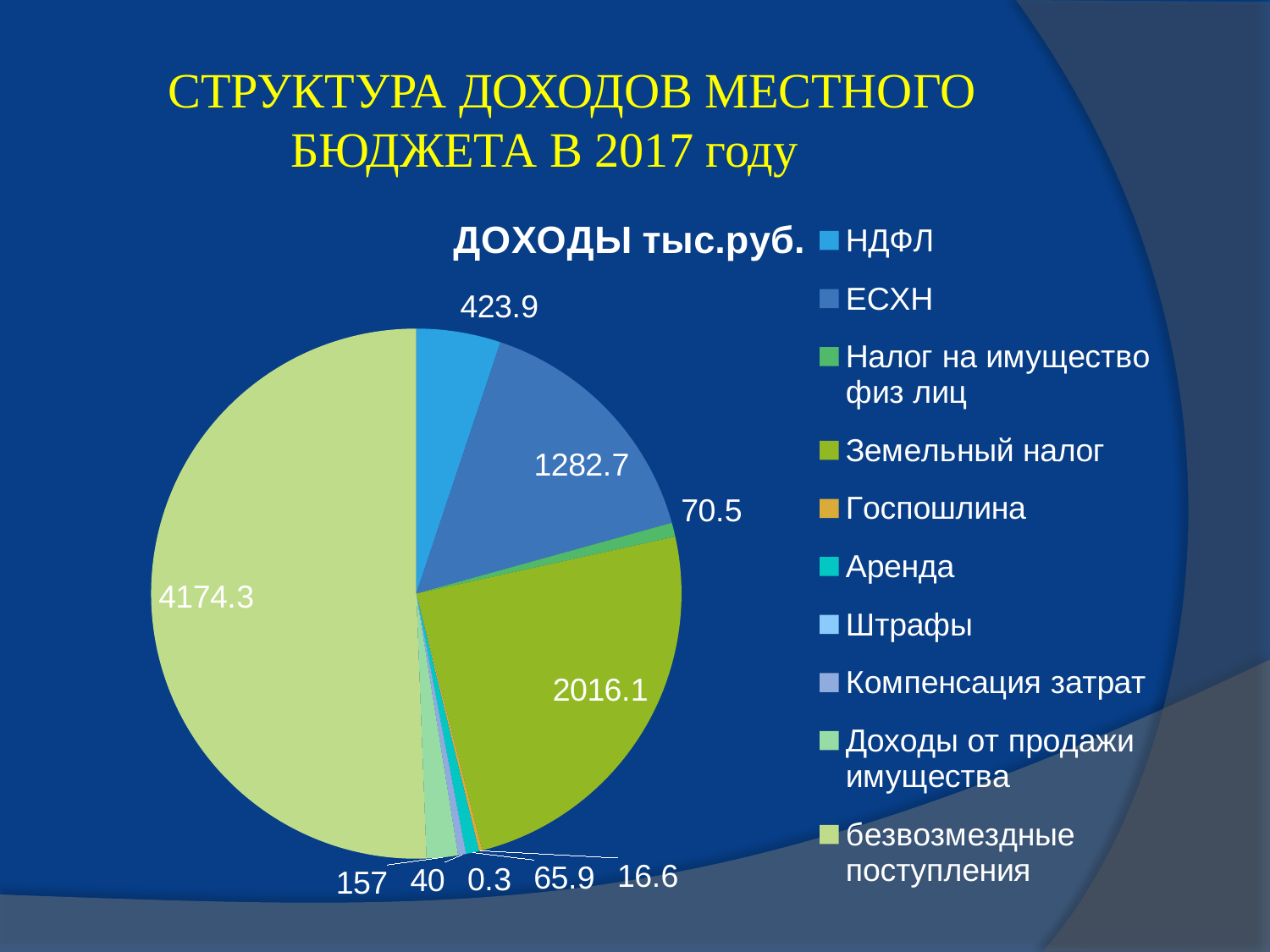
What is the title of the chart? ДОХОДЫ тыс.руб. What is the value for НДФЛ? 423.9 Which category has the largest slice of the pie? безвозмездные поступления What is the value for ЕСХН? 1282.7 What is the value for Налог на имущество физ лиц? 70.5 Which is larger, ЕСХН or НДФЛ? ЕСХН What is the value for Земельный налог? 2016.1 What kind of chart is shown on the slide? pie chart What is the difference between безвозмездные поступления and Земельный налог? 2158.2 How many categories does the legend of the pie chart list? 10 Which category has the smallest slice of the pie? Штрафы What is the value for безвозмездные поступления? 4174.3